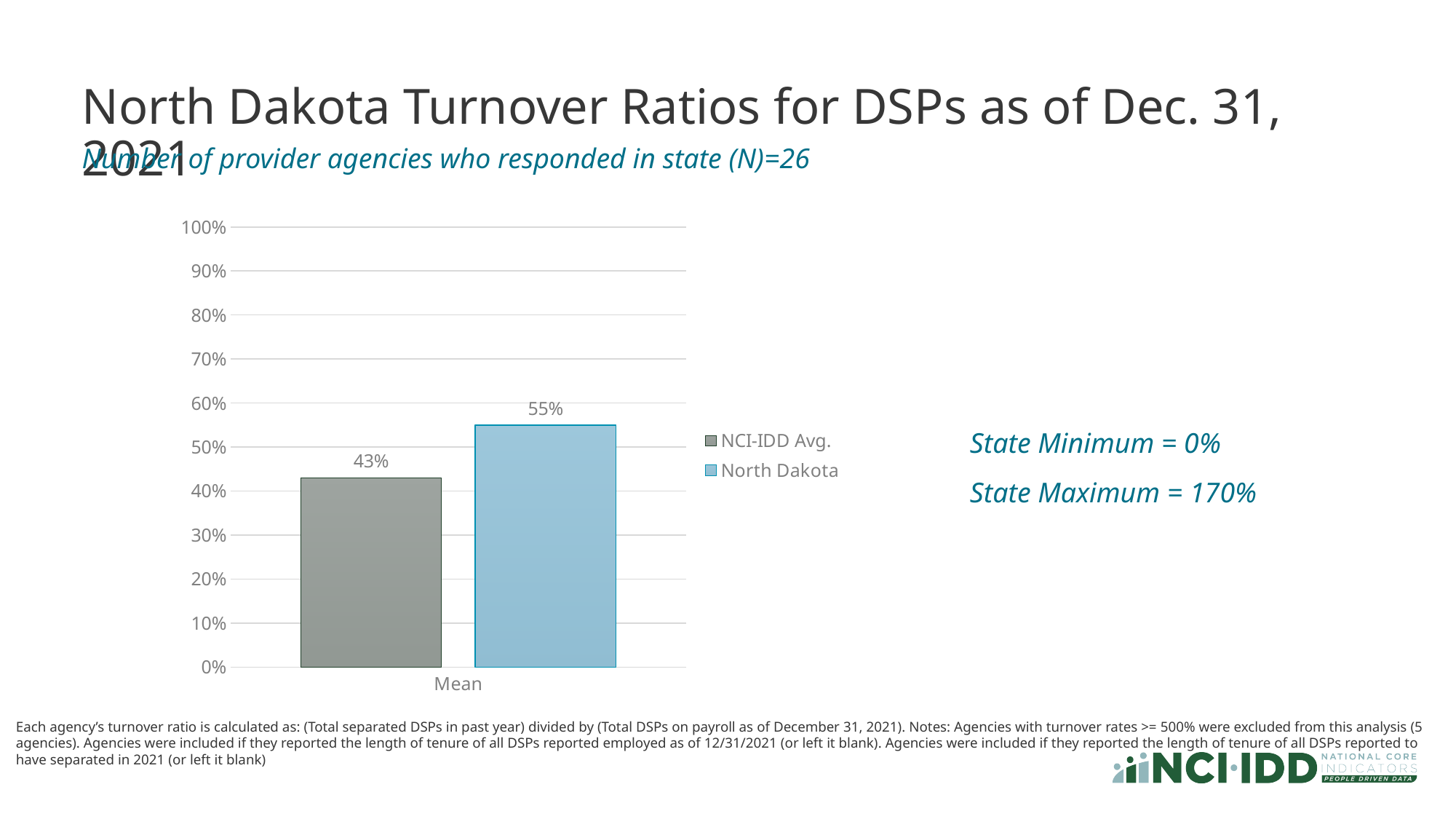
What is the NCI-IDD Avg. turnover ratio shown in the chart? 43% Which series has the lowest value in the chart? NCI-IDD Avg. Which series has the higher value in the chart, NCI-IDD Avg. or North Dakota? North Dakota What is the state maximum turnover ratio stated on the slide? 170% Is the North Dakota value greater or less than 50%? greater What is the category label on the x axis of the chart? Mean How many series does the legend list? 2 What is the North Dakota turnover ratio shown in the chart? 55% Is the NCI-IDD Avg. value greater or less than 50%? less What kind of chart is shown on the slide? Bar chart How many bars are plotted in the chart? 2 What is the difference between the North Dakota value and the NCI-IDD Avg. value? 12%